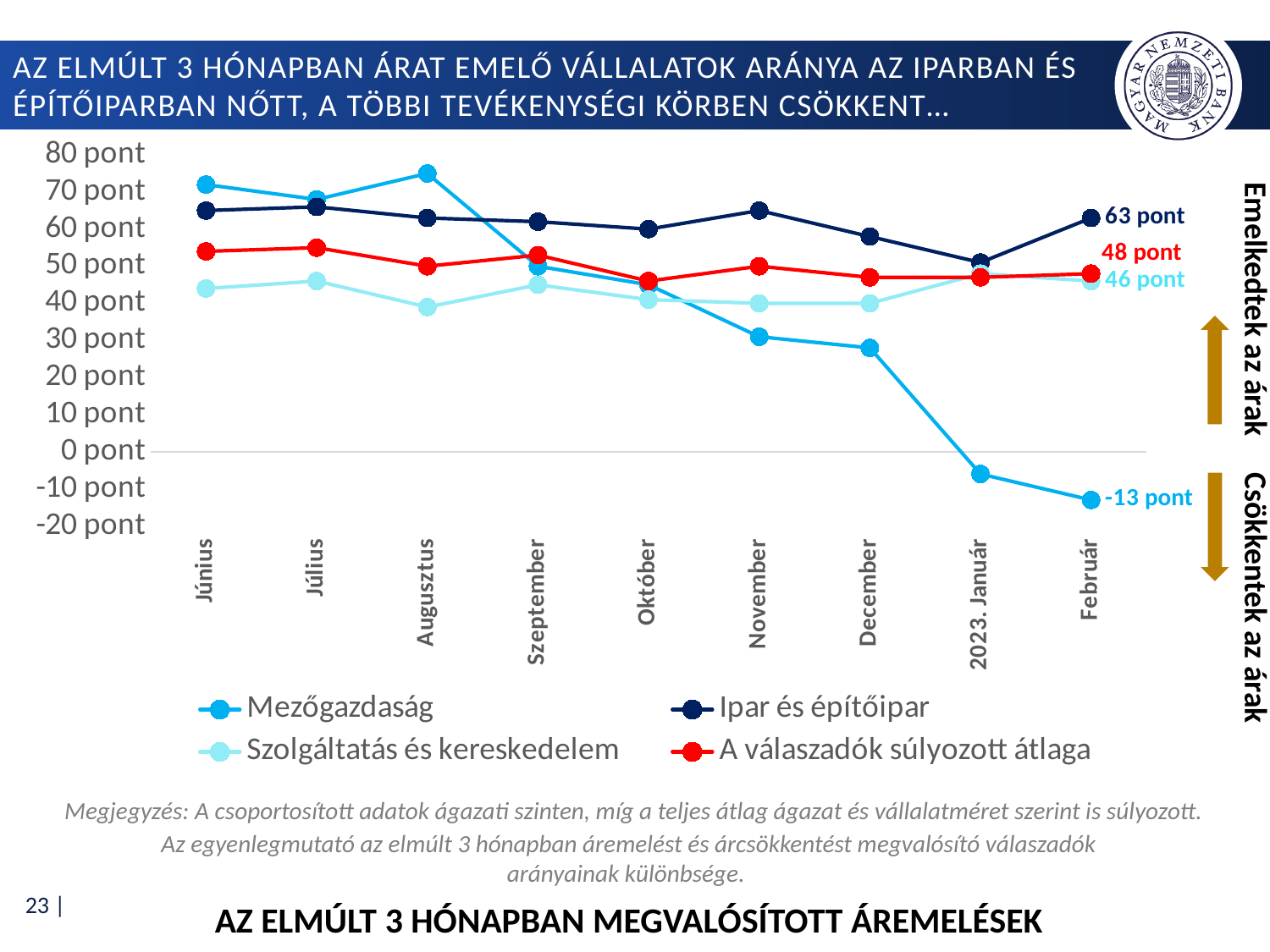
What kind of chart is shown on the slide? line chart Does the Mezőgazdaság series rise or fall from Június to Február? fall How many series does the legend list? 4 What is the value for Ipar és építőipar in Február? 63 pont How many months are shown on the x axis? 9 In Február, which is larger: the value for Ipar és építőipar or the value for A válaszadók súlyozott átlaga? Ipar és építőipar Is the value for Mezőgazdaság in 2023. Január greater or less than 0 pont? less What is the value for A válaszadók súlyozott átlaga in Február? 48 pont What is the value for Mezőgazdaság in Február? -13 pont In Február, what is the difference between the value for Ipar és építőipar and the value for Mezőgazdaság? 76 pont What is the value for Szolgáltatás és kereskedelem in Február? 46 pont Which series has the lowest value in Február? Mezőgazdaság